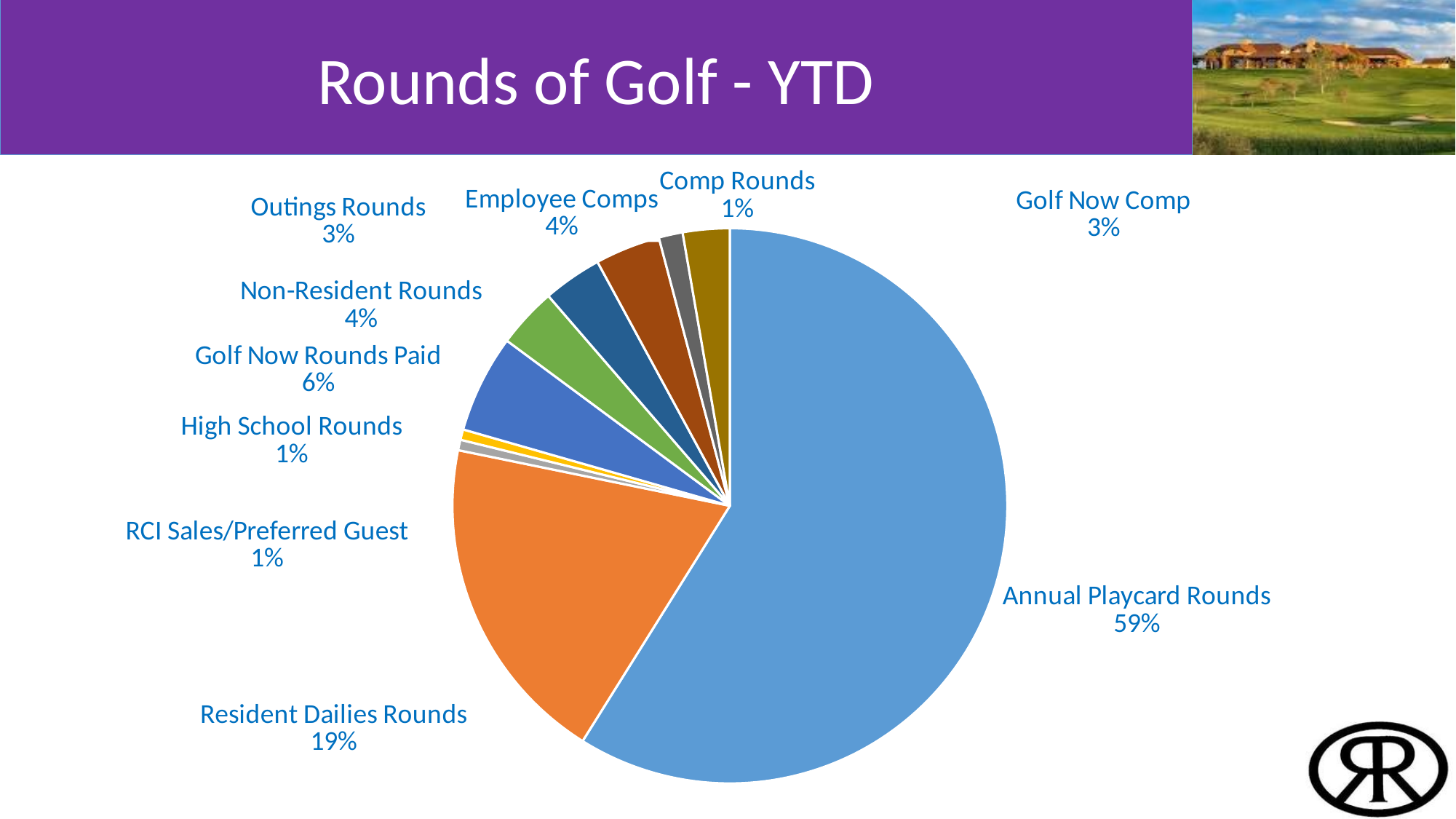
What is the difference in percentage points between Annual Playcard Rounds and Resident Dailies Rounds? 40 Which category has the largest share of the pie? Annual Playcard Rounds What share of rounds is Annual Playcard Rounds? 59% Which is larger, Golf Now Rounds Paid or Non-Resident Rounds? Golf Now Rounds Paid What percentage is shown for Golf Now Rounds Paid? 6% What share of rounds is Resident Dailies Rounds? 19% What is the combined share of Golf Now Comp and Comp Rounds? 4% What kind of chart is shown on the slide? pie chart What is the title of the slide? Rounds of Golf - YTD What percentage is shown for Employee Comps? 4% How many categories are shown in the pie chart? 10 What percentage is shown for Outings Rounds? 3%